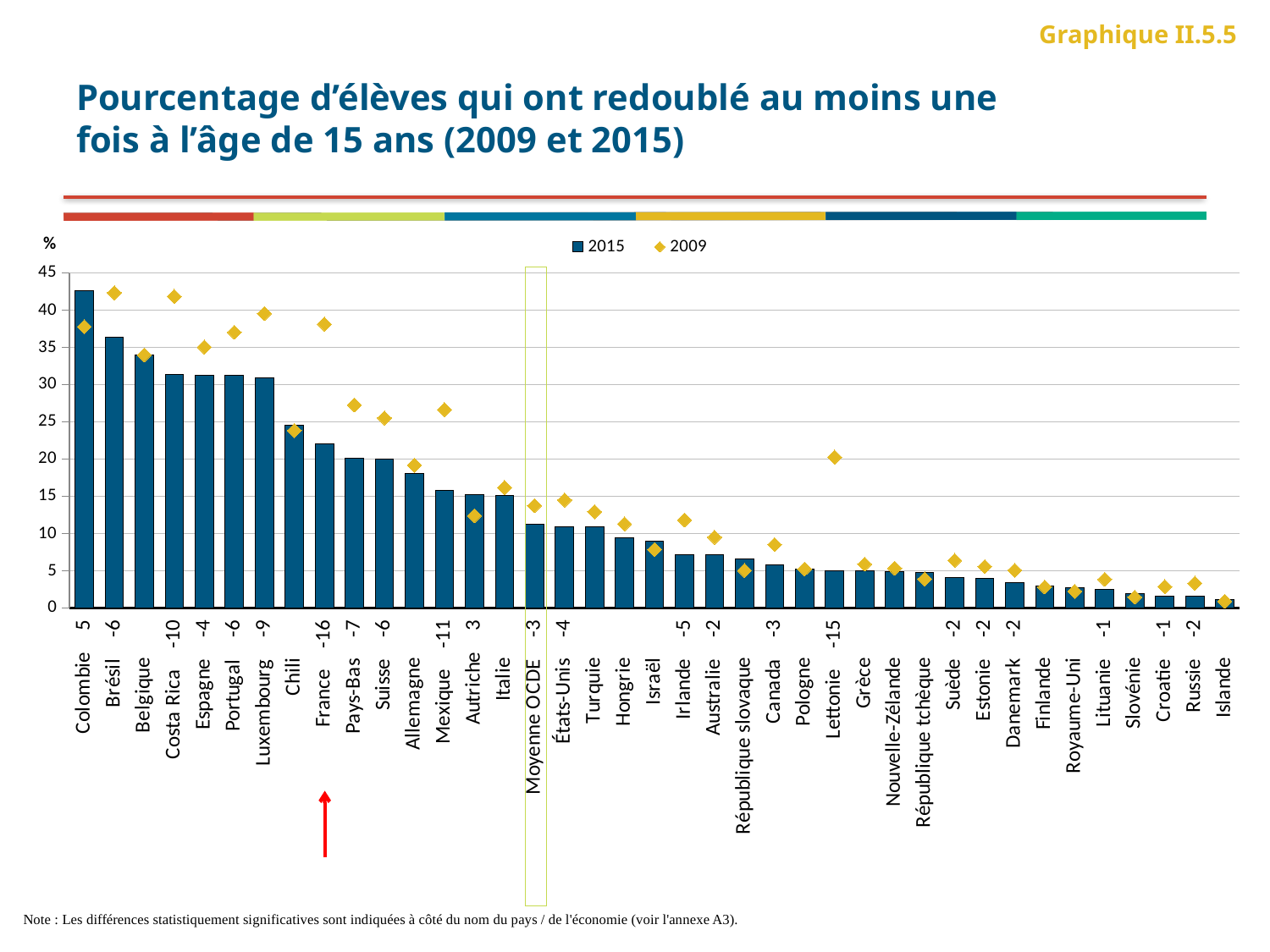
What number is printed next to France on the x axis? -16 How many series does the legend list? 2 Is the 2015 value for France greater or less than 20? greater Which has the larger 2015 value, Brésil or Belgique? Brésil Which country has the highest 2015 value? Colombie Do the 2015 bars rise or fall from left to right along the x axis? fall What kind of chart is shown on the slide? bar chart What number is printed next to Lettonie on the x axis? -15 Which country has the lowest 2015 value? Islande Is the 2009 value for Mexique greater or less than 25? greater Is the 2015 value for Allemagne greater or less than 20? less